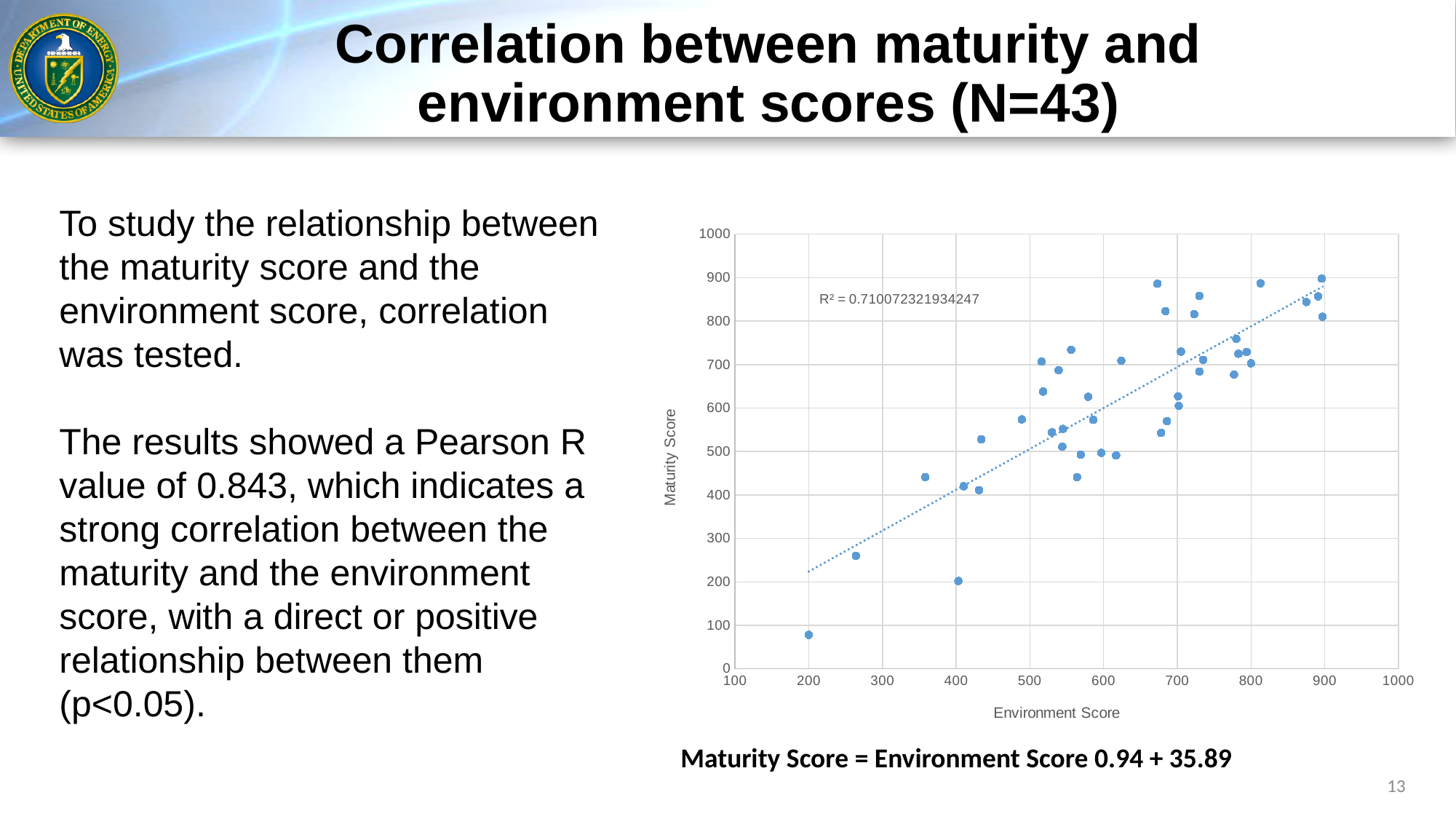
Is the maturity score of the point with an environment score of about 265 greater or less than 300? less Is the maturity score of the point with the lowest environment score (about 200) greater or less than 200? less According to the slide title, how many observations (N) are plotted in the chart? 43 Is the lowest maturity score plotted on the chart greater or less than 100? less As the environment score increases along the x axis, do the maturity scores generally rise or fall? rise Which has the higher maturity score: the point at an environment score of about 200 or the point at about 900? the point at about 900 What R² value is printed on the chart? R² = 0.710072321934247 What kind of chart is shown on the slide? scatter plot What is the label of the x axis of the chart? Environment Score